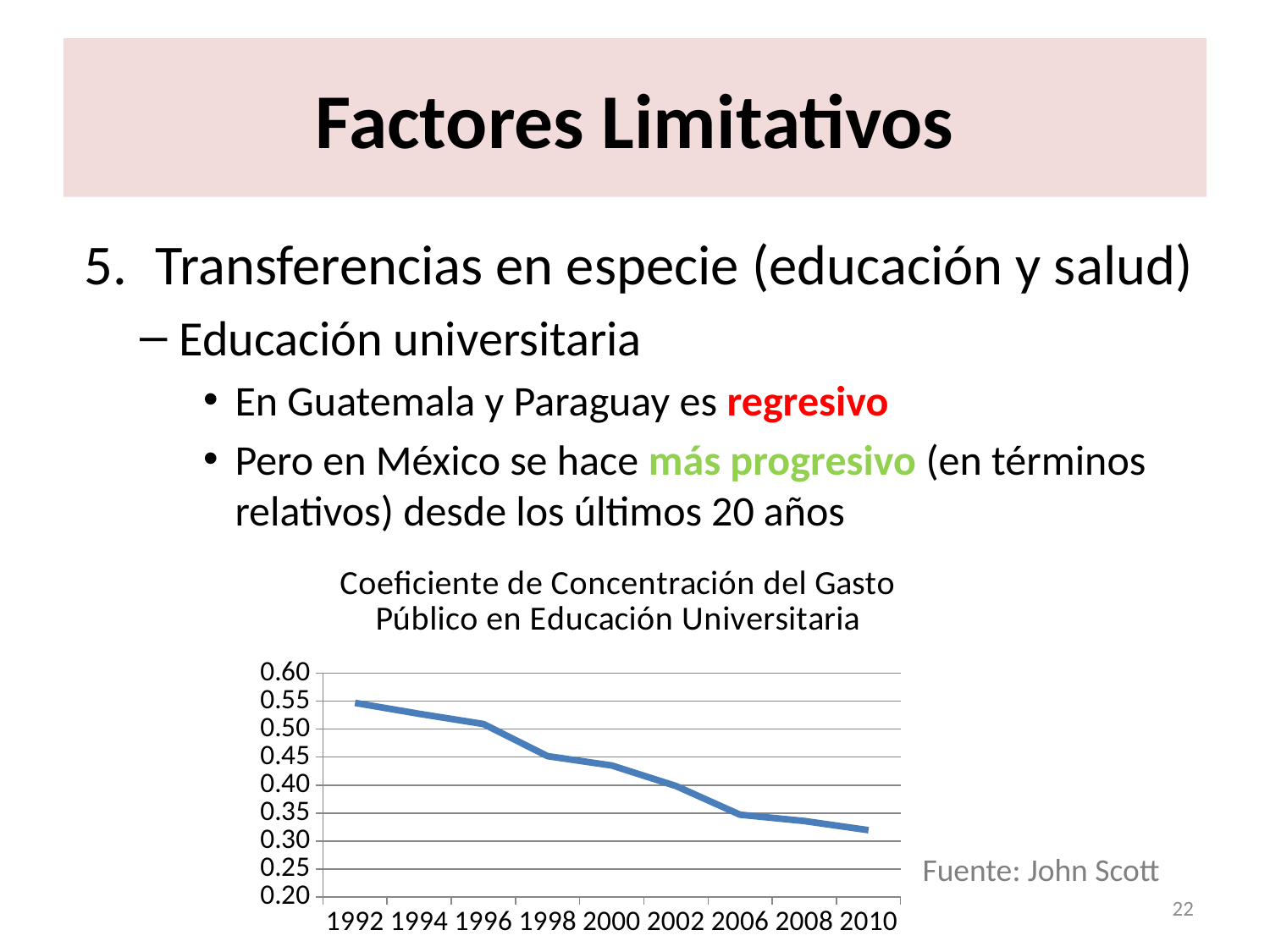
Is the value for 1992 greater or less than 0.50? greater Is the value for 2002 greater or less than 0.35? greater How many years are plotted on the x axis of the chart? 9 Is the value for 1998 greater or less than 0.50? less Which year has the lowest value in the chart? 2010 Which is larger, the value for 1996 or the value for 2008? 1996 Which year has the highest value in the chart? 1992 What kind of chart is shown on the slide? line chart What is the title of the chart? Coeficiente de Concentración del Gasto Público en Educación Universitaria Do the values in the chart rise or fall from 1992 to 2010? fall